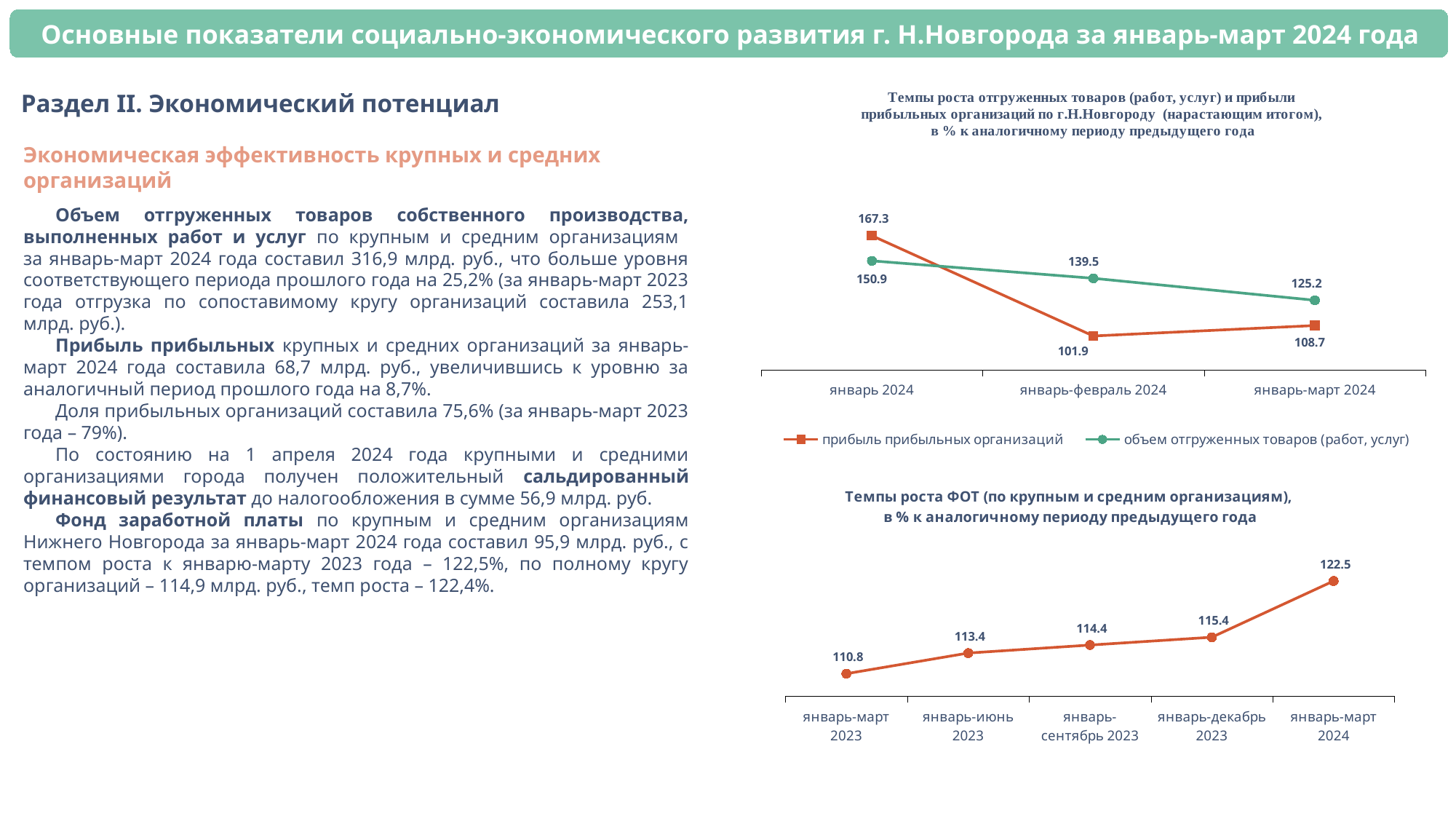
In the bottom chart (Темпы роста ФОТ), which period has the lowest value? январь-март 2023 In the top chart, which series has the higher value for январь 2024: прибыль прибыльных организаций or объем отгруженных товаров? прибыль прибыльных организаций In the top chart, what is the value of объем отгруженных товаров (работ, услуг) for январь-март 2024? 125.2 How many data points are plotted in the bottom chart (Темпы роста ФОТ)? 5 How many series does the legend of the top chart list? 2 In the top chart, what is the value of прибыль прибыльных организаций for январь-февраль 2024? 101.9 In the top chart, which period has the lowest value for прибыль прибыльных организаций? январь-февраль 2024 In the bottom chart (Темпы роста ФОТ), what is the value for январь-март 2024? 122.5 What type of chart is the bottom chart (Темпы роста ФОТ)? line chart In the top chart (Темпы роста отгруженных товаров и прибыли), what is the value of прибыль прибыльных организаций for январь 2024? 167.3 In the top chart, what is the difference between объем отгруженных товаров and прибыль прибыльных организаций for январь-март 2024? 16.5 In the top chart, does the value of объем отгруженных товаров rise or fall from январь 2024 to январь-март 2024? fall